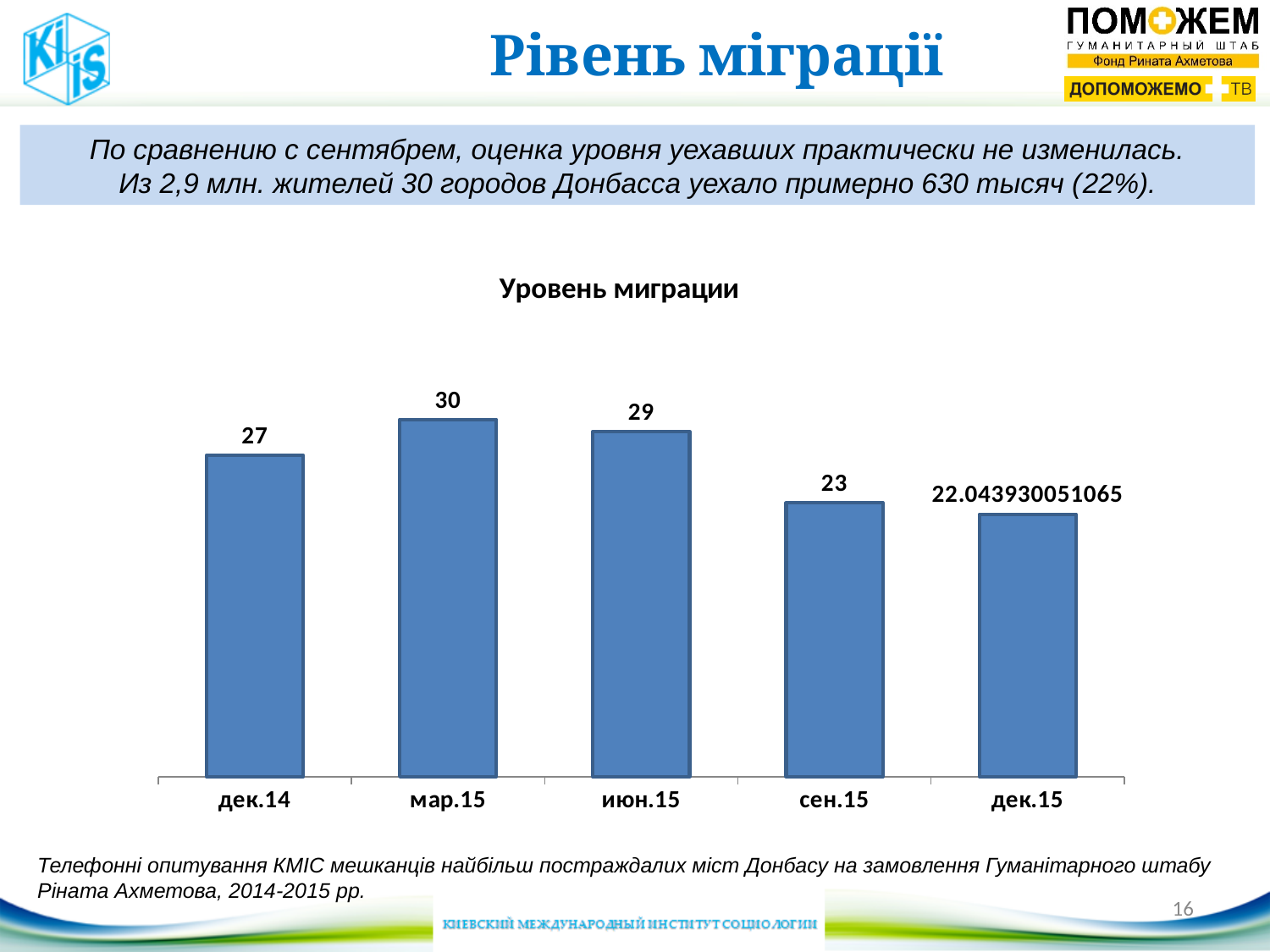
What kind of chart is this? bar chart What is the difference between the values for июн.15 and дек.14? 2 Which is larger, the value for дек.14 or the value for сен.15? дек.14 What value is labelled on the bar for дек.15? 22.043930051065 How many categories are shown on the x axis? 5 Which category has the lowest value? дек.15 What is the value for дек.14? 27 What is the difference between the values for мар.15 and сен.15? 7 What is the title of the chart? Уровень миграции What is the value for сен.15? 23 What is the value for мар.15? 30 Which category has the highest value? мар.15